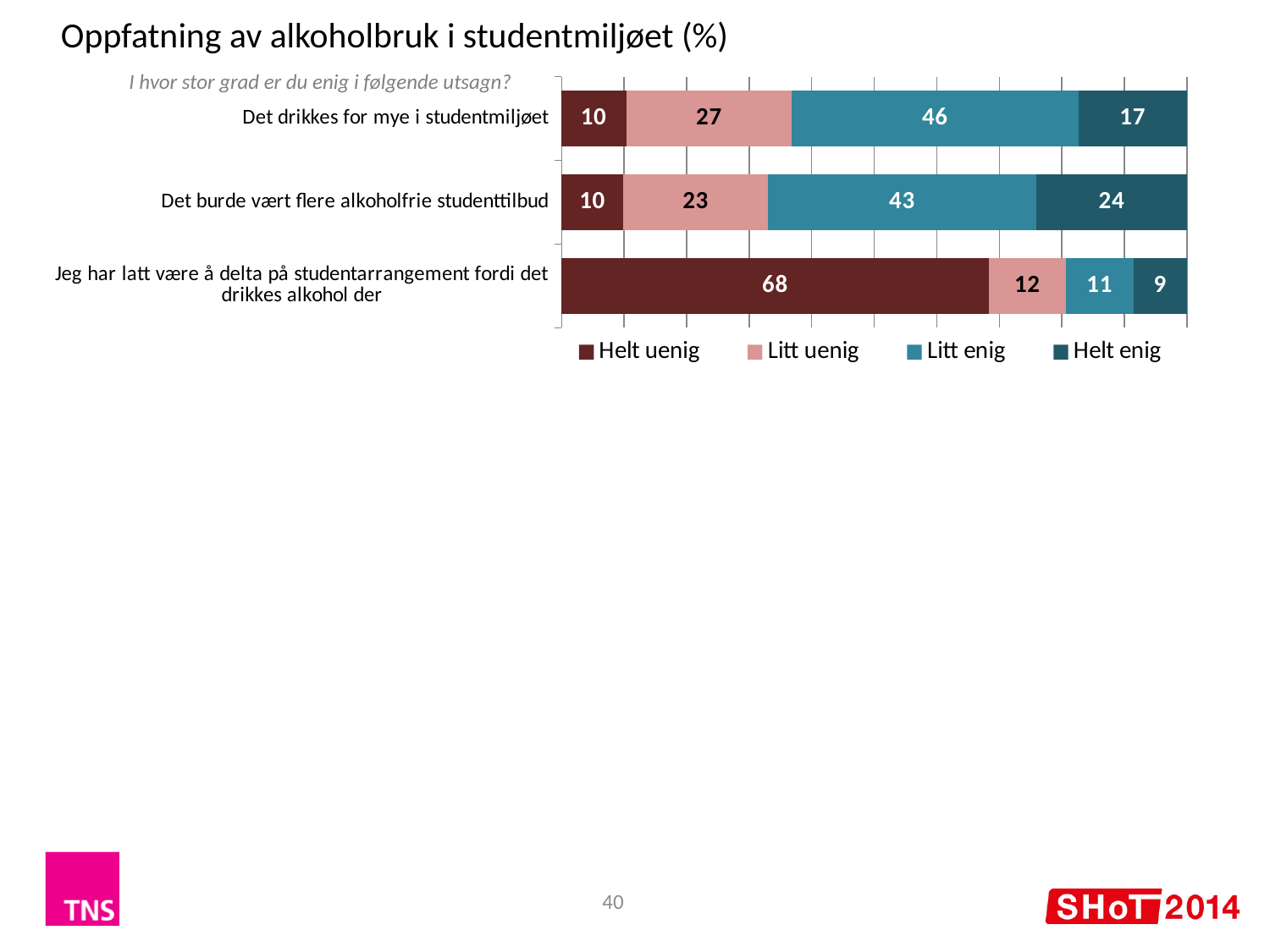
What is the value for "Helt uenig" for "Jeg har latt være å delta på studentarrangement fordi det drikkes alkohol der"? 68 What is the value for "Helt enig" for "Det drikkes for mye i studentmiljøet"? 17 What is the total of the stacked bar for "Jeg har latt være å delta på studentarrangement fordi det drikkes alkohol der"? 100 What is the value for "Litt enig" for "Det burde vært flere alkoholfrie studenttilbud"? 43 What kind of chart is shown on the slide? Stacked bar chart What is the value for "Litt uenig" for "Det drikkes for mye i studentmiljøet"? 27 Which is larger: the "Litt enig" value for "Det drikkes for mye i studentmiljøet" or for "Det burde vært flere alkoholfrie studenttilbud"? Det drikkes for mye i studentmiljøet How many statements (categories) are shown in the chart? 3 What is the difference between the "Helt enig" values for "Det burde vært flere alkoholfrie studenttilbud" and "Det drikkes for mye i studentmiljøet"? 7 Which statement has the highest "Helt uenig" value? Jeg har latt være å delta på studentarrangement fordi det drikkes alkohol der How many series does the legend list? 4 Which statement has the lowest "Helt enig" value? Jeg har latt være å delta på studentarrangement fordi det drikkes alkohol der